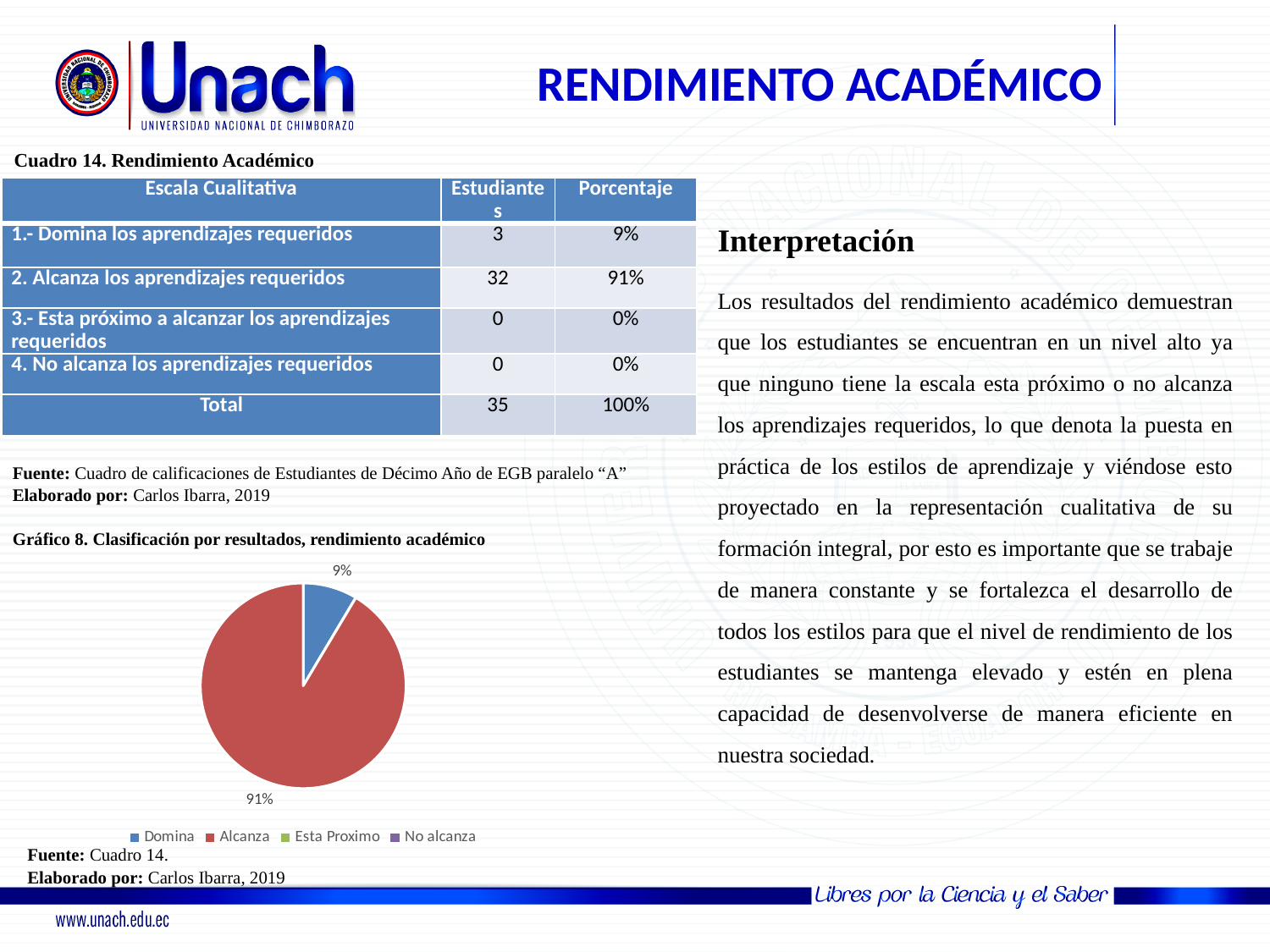
In the pie chart, what percentage is shown for the 'Alcanza' slice? 91% In the pie chart, what percentage is shown for the 'Domina' slice? 9% What is the difference in percentage points between the 'Alcanza' slice and the 'Domina' slice in the pie chart? 82 Which category has the largest slice in the pie chart? Alcanza What kind of chart is shown under 'Gráfico 8. Clasificación por resultados, rendimiento académico'? pie chart What share of the pie does the 'Domina' slice represent? 9% What colour is the 'Alcanza' slice in the pie chart? red What colour is the 'Domina' slice in the pie chart? blue How many entries does the legend of the pie chart list? 4 In the pie chart, which slice is larger, 'Domina' or 'Alcanza'? Alcanza How many percentage data labels are printed on the pie chart? 2